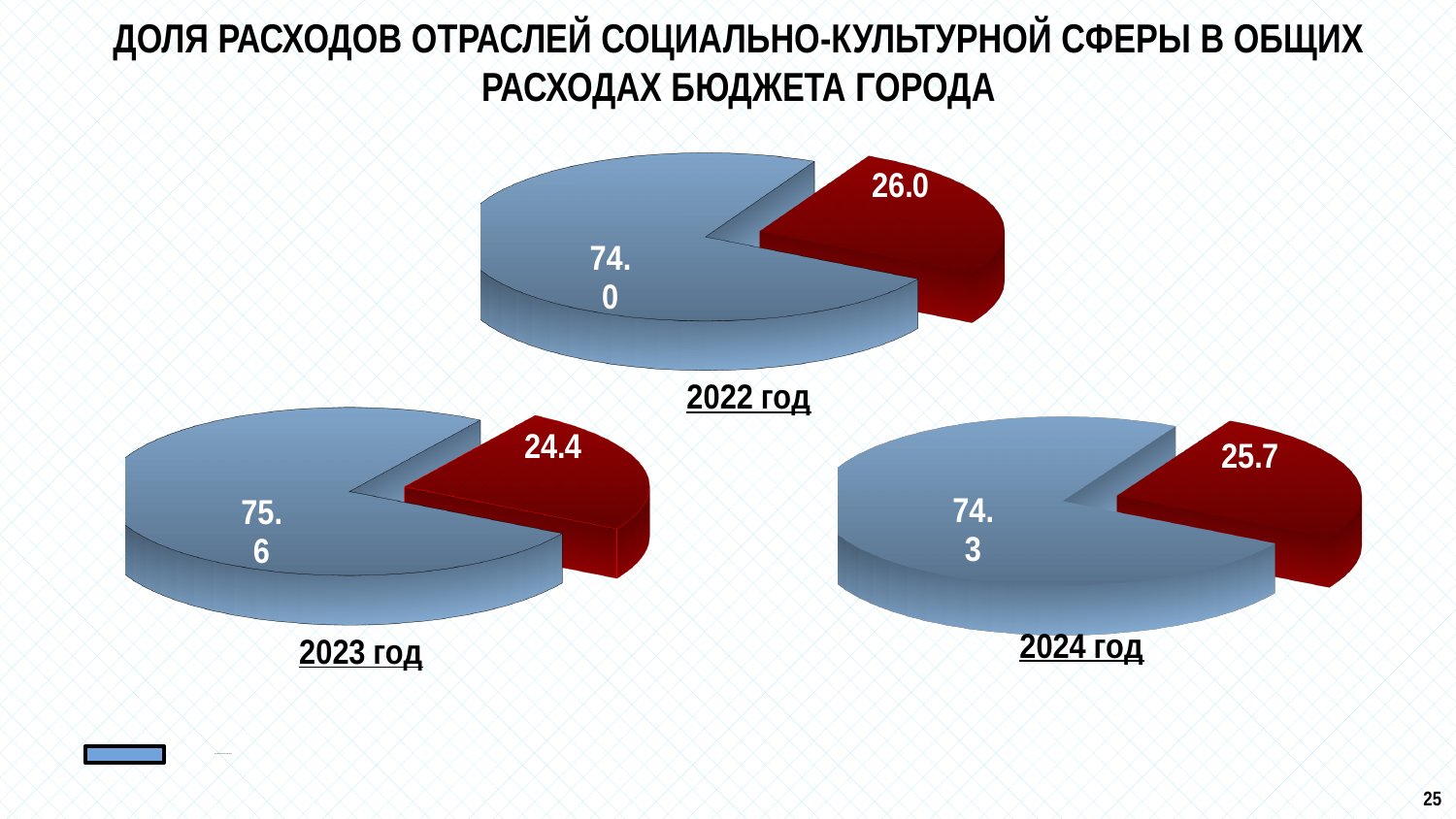
What is the value of the blue slice in the 2023 год pie chart? 75.6 What is the value of the red slice in the 2024 год pie chart? 25.7 What is the value of the red slice in the 2023 год pie chart? 24.4 What kind of chart is used for the 2022 год data? Pie chart In which year's pie chart is the red slice the smallest? 2023 год What is the value of the red slice in the 2022 год pie chart? 26.0 What is the value of the blue slice in the 2022 год pie chart? 74.0 In the 2022 год pie chart, what is the difference between the blue slice and the red slice? 48.0 In which year's pie chart is the red slice the largest? 2022 год What is the value of the blue slice in the 2024 год pie chart? 74.3 Which is larger: the red slice in the 2024 год chart or the red slice in the 2023 год chart? 2024 год How many slices does the 2023 год pie chart have? 2